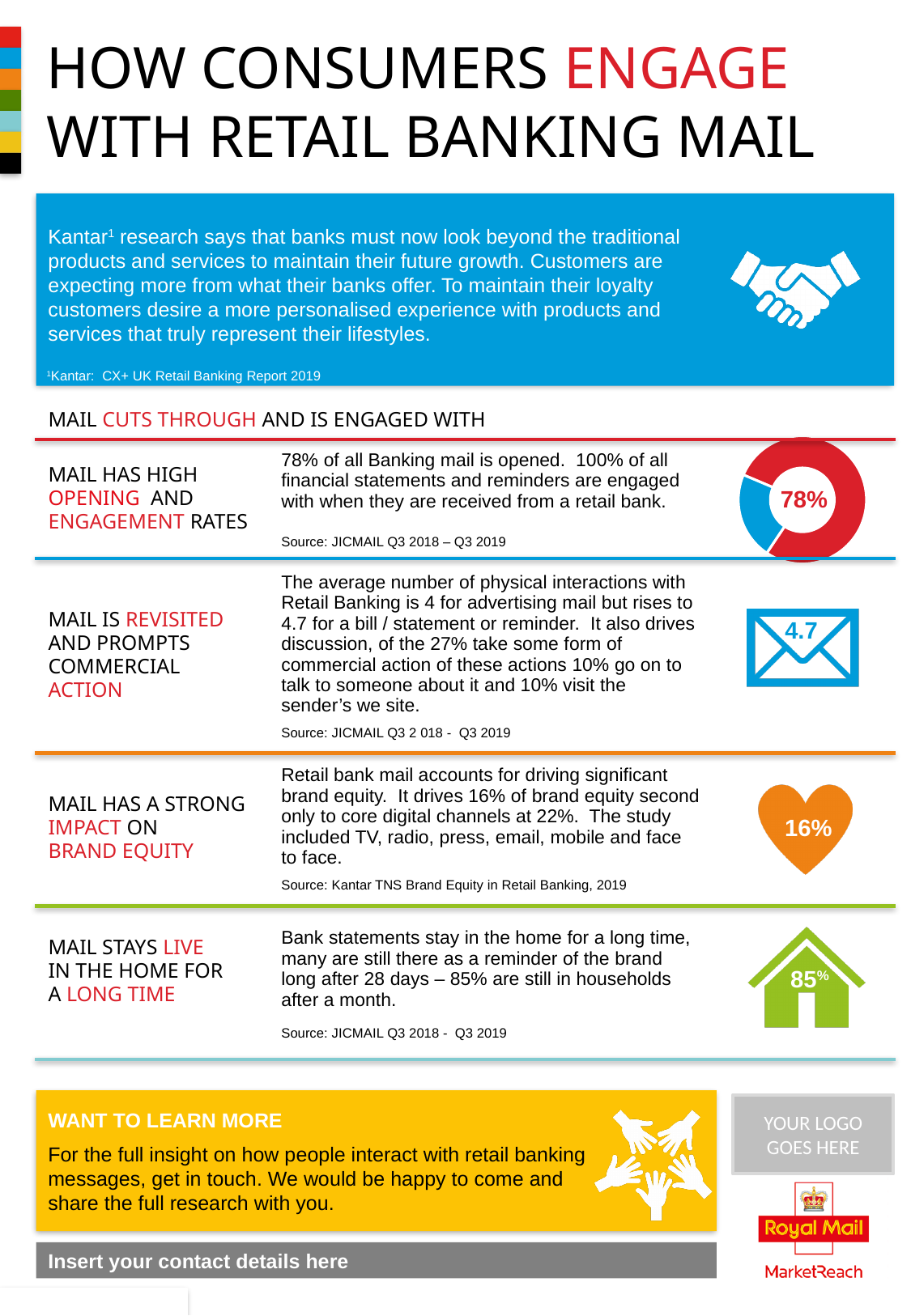
Which slice of the pie chart is larger, the red one or the blue one? red What percentage of all Banking mail is opened, according to the pie chart? 78% What kind of chart is shown next to the 'Mail has high opening and engagement rates' row? doughnut chart How many slices does the pie chart have? 2 Is the blue slice of the pie chart greater or less than 50%? less What colour is the slice of the pie chart that represents the 78% of banking mail that is opened? red Is the red slice of the pie chart greater or less than 50%? greater What colour is the smaller slice of the pie chart? blue What value is printed in the centre of the pie chart? 78%